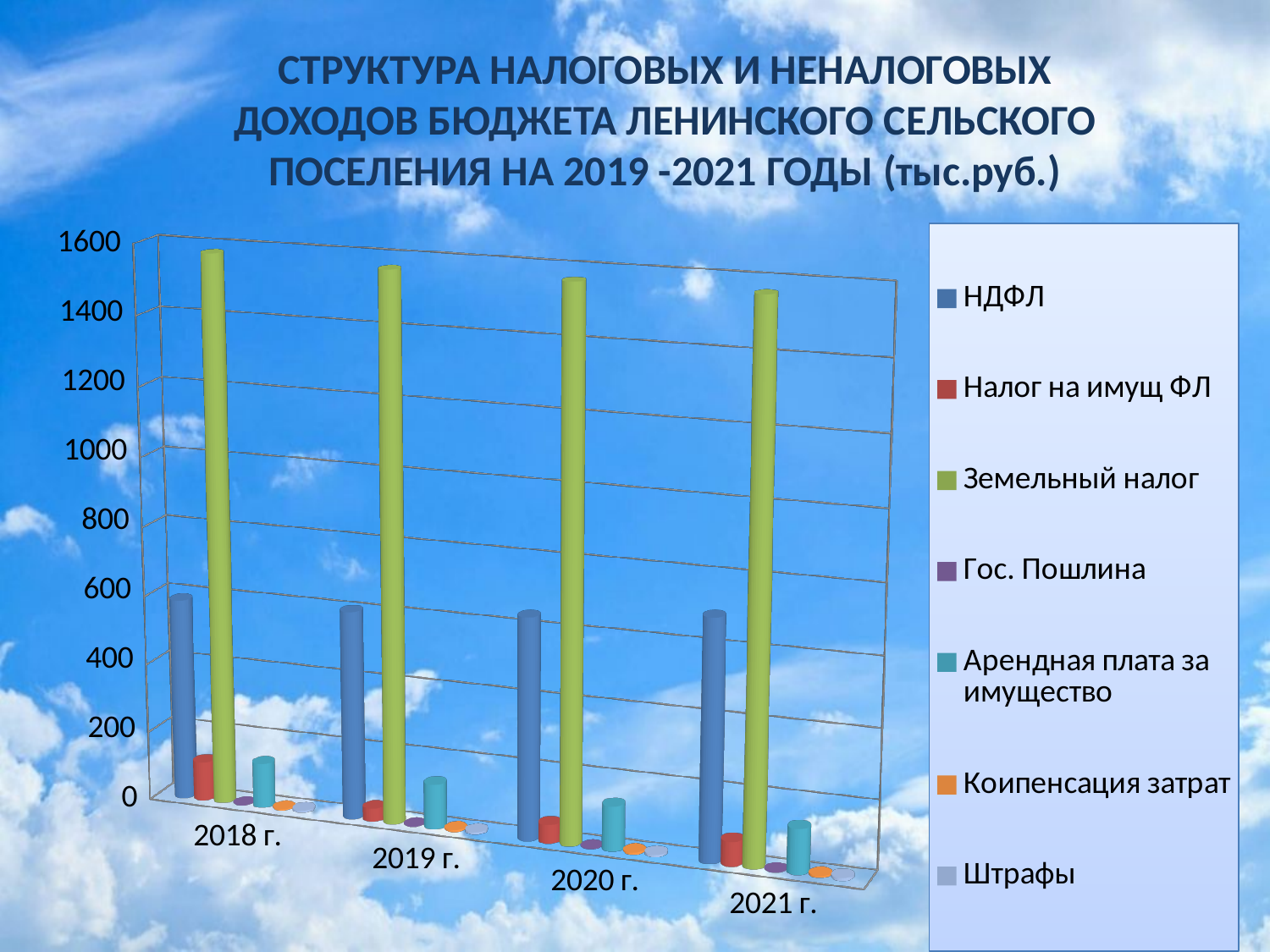
Which legend entry is shown in green? Земельный налог How many years (categories) are shown on the x axis of the chart? 4 In 2019 г., which is larger: НДФЛ or Земельный налог? Земельный налог Is the value for Налог на имущ ФЛ in 2018 г. greater or less than 200? less What kind of chart is shown on the slide? bar chart Is the value for Земельный налог in 2021 г. greater or less than 1200? greater In which year is the value for Земельный налог the highest? 2018 г. How many series does the chart legend list? 7 Is the value for Земельный налог in 2018 г. greater or less than 1400? greater Which series has the highest value in 2020 г.? Земельный налог Does the value for Земельный налог rise or fall from 2018 г. to 2021 г.? fall